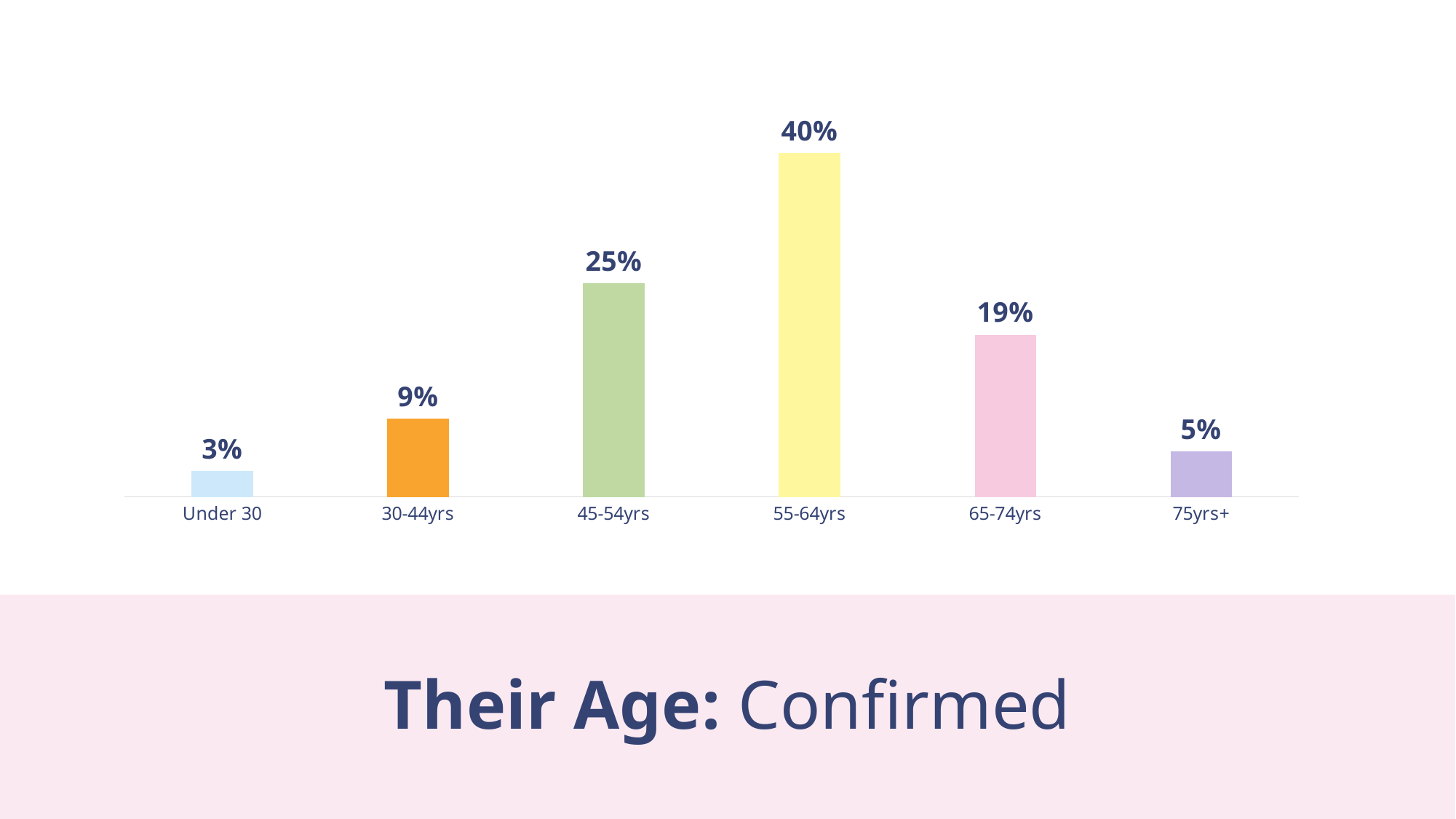
Do the values rise or fall from Under 30 to 55-64yrs? Rise What is the difference between the values for 30-44yrs and 75yrs+? 4% Which age group has the highest value? 55-64yrs How many age categories are shown in the chart? 6 Which age group has the lowest value? Under 30 What is the title text shown at the bottom of the slide? Their Age: Confirmed Which is larger, the value for 45-54yrs or the value for 65-74yrs? 45-54yrs What kind of chart is shown on the slide? Bar chart What percentage is shown for the 55-64yrs age group? 40% What is the difference between the values for 55-64yrs and 45-54yrs? 15% What percentage is shown for the 65-74yrs age group? 19% What is the value for the Under 30 category? 3%